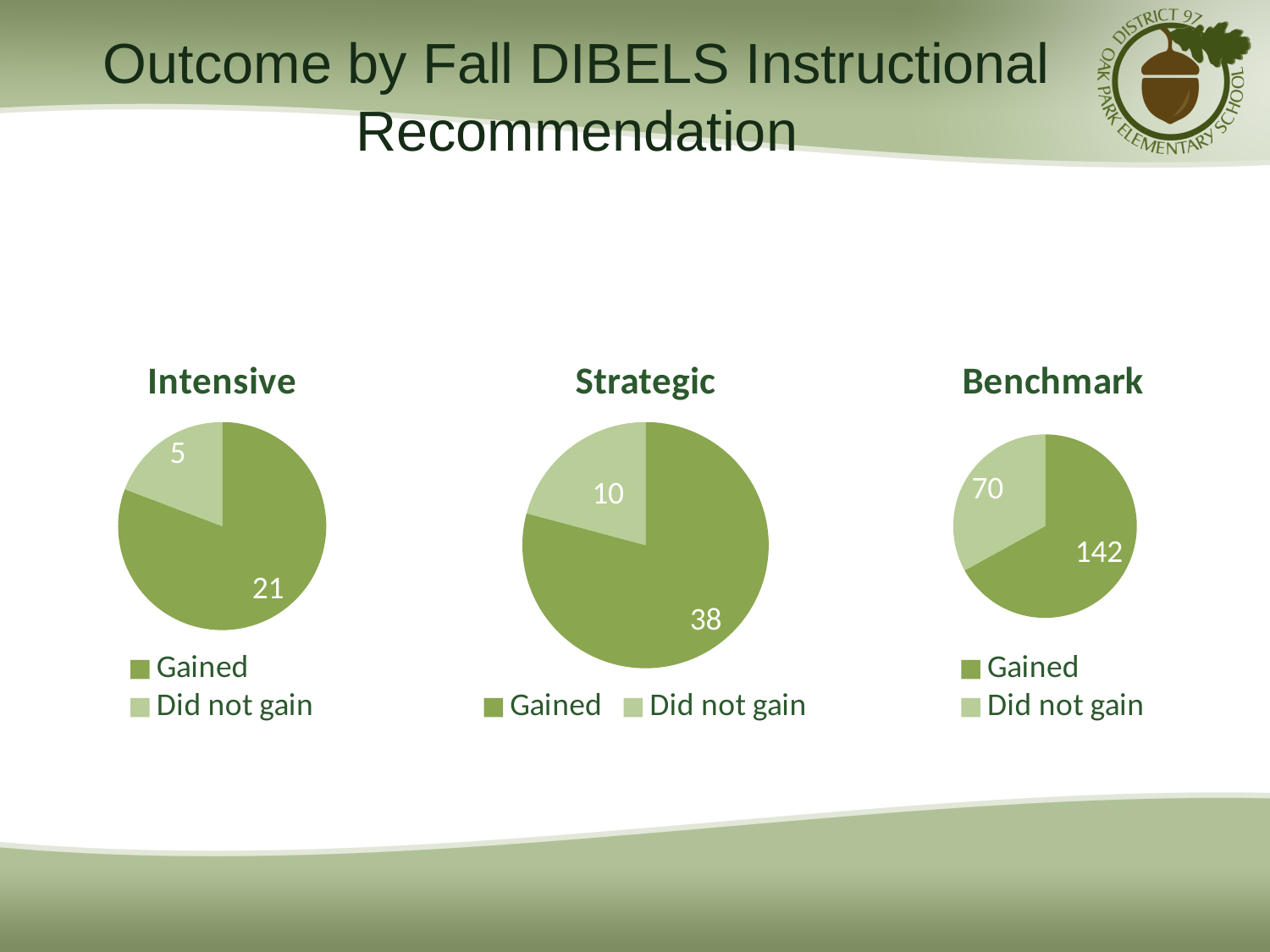
In the Intensive chart, how many students gained? 21 In the Benchmark chart, what is the value for Did not gain? 70 In the Strategic chart, what is the value for Did not gain? 10 In the Intensive chart, which slice is larger, Gained or Did not gain? Gained How many pie charts are shown on the slide? 3 How many series does the legend of the Strategic chart list? 2 In the Intensive chart, how many students did not gain? 5 In the Strategic chart, what is the total number of students represented? 48 In the Benchmark chart, what is the difference between Gained and Did not gain? 72 What type of chart is used for the Benchmark group? Pie chart In the Strategic chart, what is the value for Gained? 38 In the Benchmark chart, what is the value for Gained? 142